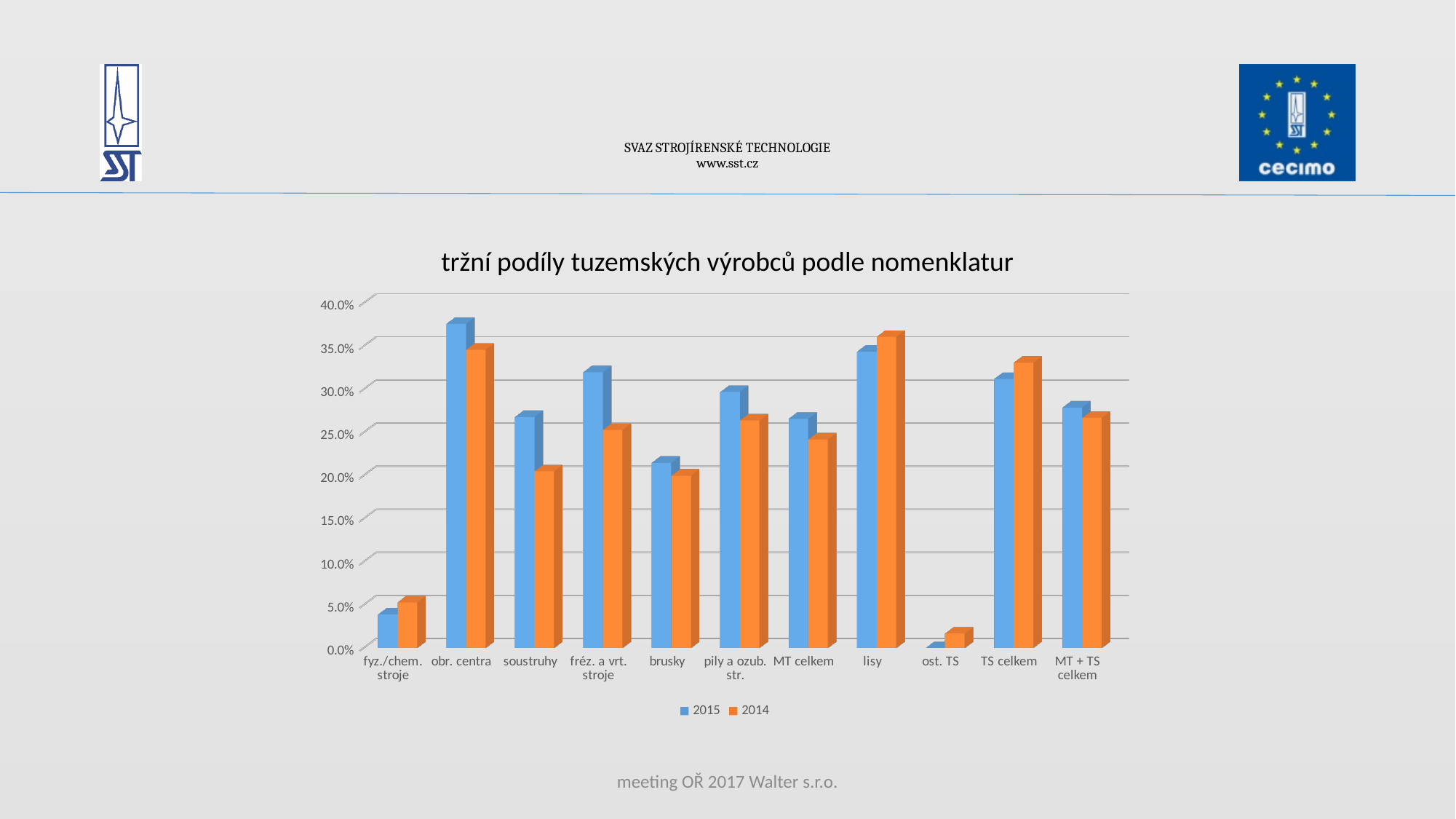
What kind of chart is shown on the slide? bar chart For lisy, which series has the larger value, 2015 or 2014? 2014 How many categories are shown on the x axis of the chart? 11 For soustruhy, which series has the larger value, 2015 or 2014? 2015 Which category has the lowest value for the 2014 series? ost. TS Is the 2014 value for fréz. a vrt. stroje greater or less than 30.0%? less How many series does the legend list? 2 Which category has the highest value for the 2014 series? lisy Is the 2015 value for obr. centra greater or less than 35.0%? greater Which category has the highest value for the 2015 series? obr. centra What is the title of the chart? tržní podíly tuzemských výrobců podle nomenklatur Which category has the lowest value for the 2015 series? ost. TS